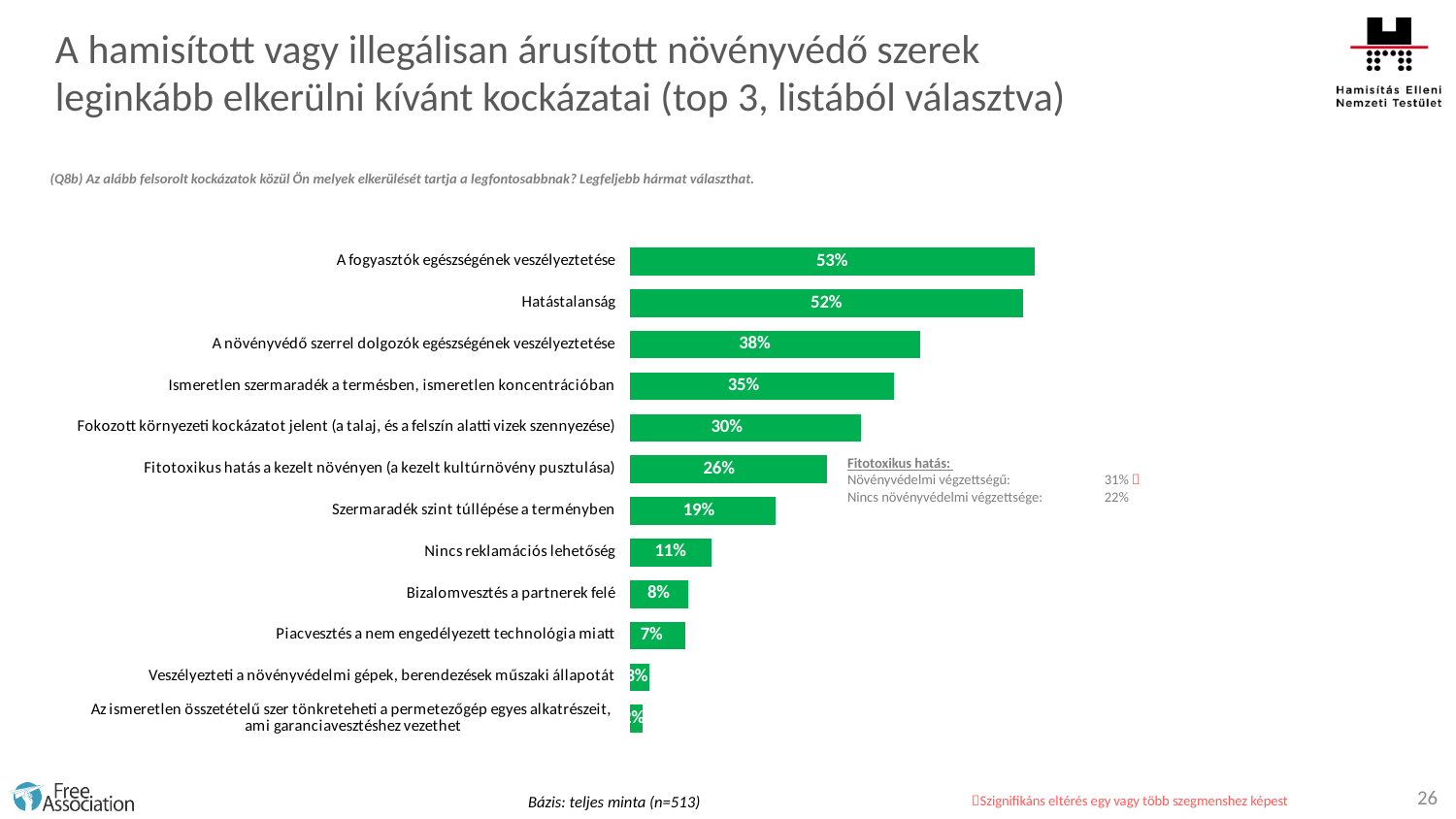
According to the annotation next to the 'Fitotoxikus hatás' bar, what is the value for respondents with plant protection qualification (Növényvédelmi végzettségű)? 31% What kind of chart is shown on the slide? Bar chart What is the value for 'Nincs reklamációs lehetőség'? 11% What is the value for 'Ismeretlen szermaradék a termésben, ismeretlen koncentrációban'? 35% What is the value for 'A fogyasztók egészségének veszélyeztetése'? 53% What is the value for 'Hatástalanság'? 52% Which category has the highest value? A fogyasztók egészségének veszélyeztetése Which is larger: the value for 'Szermaradék szint túllépése a terményben' or for 'Bizalomvesztés a partnerek felé'? Szermaradék szint túllépése a terményben Which category has the lowest value? Az ismeretlen összetételű szer tönkreteheti a permetezőgép egyes alkatrészeit, ami garanciavesztéshez vezethet How many categories (risks) are plotted in the chart? 12 Do the bar values rise or fall going from the top category to the bottom category? Fall What is the difference between the values for 'A növényvédő szerrel dolgozók egészségének veszélyeztetése' and 'Fokozott környezeti kockázatot jelent'? 8 percentage points